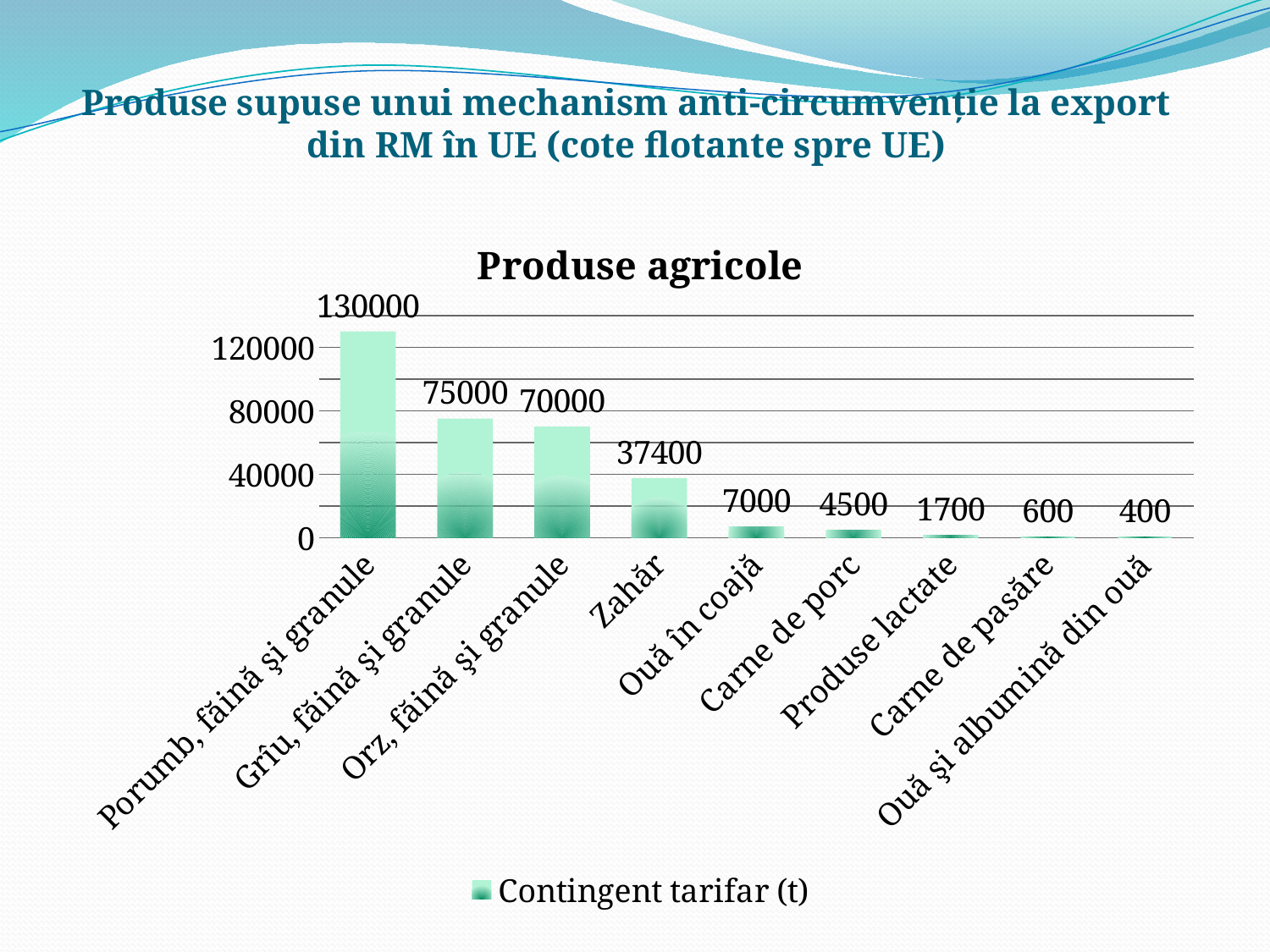
Which category has the highest value? Porumb, făină şi granule What is the value for Carne de porc? 4500 What is the title of the chart? Produse agricole What is the value for Produse lactate? 1700 What is the difference between the values for Grîu, făină şi granule and Orz, făină şi granule? 5000 What is the difference between the values for Porumb, făină şi granule and Zahăr? 92600 Which is larger, the value for Ouă în coajă or the value for Carne de porc? Ouă în coajă What is the value for Zahăr? 37400 Which category has the lowest value? Ouă şi albumină din ouă How many categories are shown on the x axis? 9 What kind of chart is shown? bar chart How many series does the legend list? 1